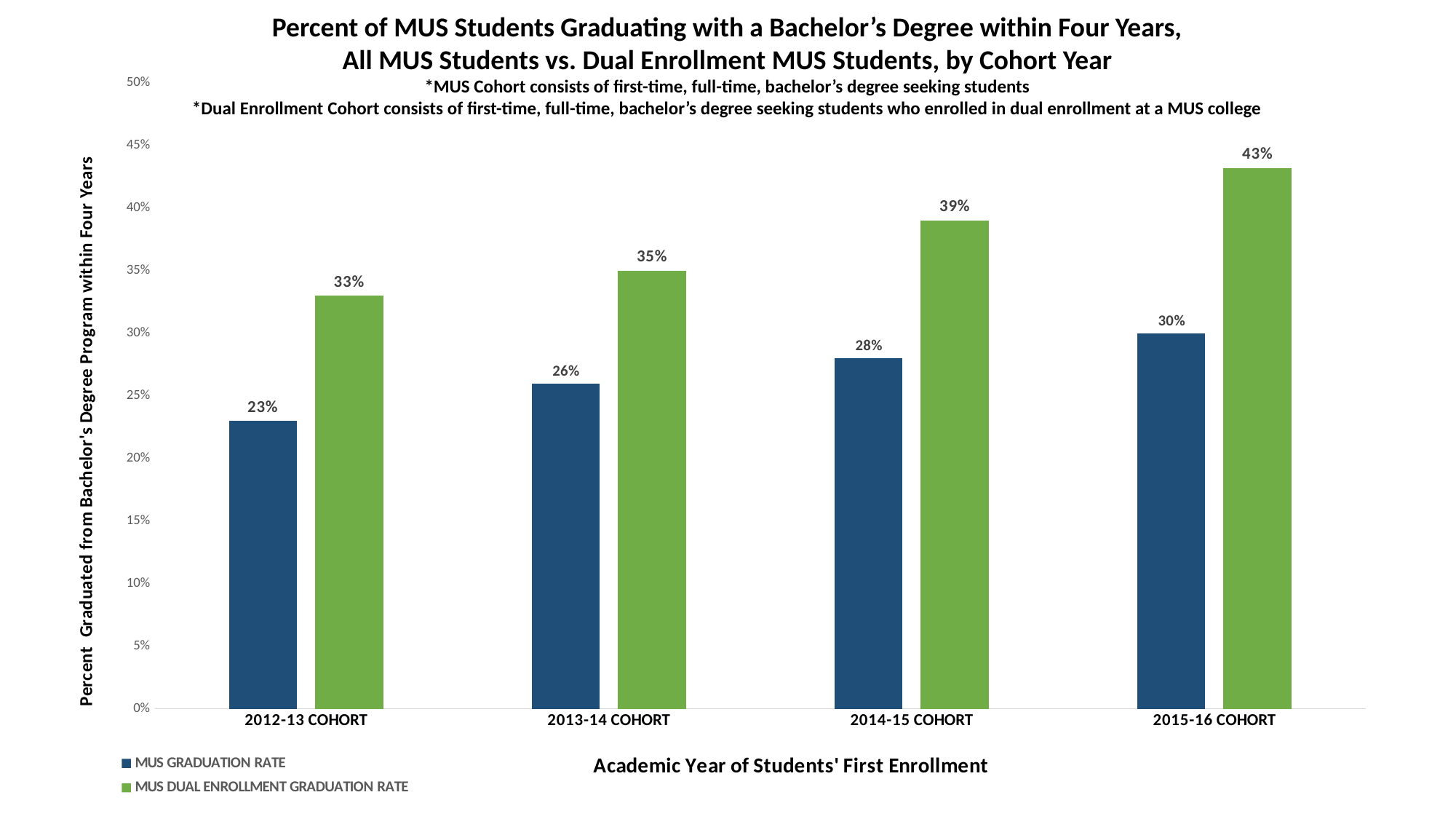
Is the MUS graduation rate for the 2015-16 cohort greater or less than 35%? less What is the difference between the MUS dual enrollment graduation rate and the MUS graduation rate for the 2014-15 cohort? 11% Do the MUS graduation rates rise or fall from the 2012-13 cohort to the 2015-16 cohort? rise What kind of chart is shown on the slide? bar chart Which cohort has the lowest MUS graduation rate? 2012-13 COHORT Which cohort has the highest MUS dual enrollment graduation rate? 2015-16 COHORT What is the MUS dual enrollment graduation rate for the 2015-16 cohort? 43% What is the MUS graduation rate for the 2012-13 cohort? 23% How many cohort years are shown on the x axis? 4 Which is larger for the 2013-14 cohort: the MUS graduation rate or the MUS dual enrollment graduation rate? MUS dual enrollment graduation rate What is the MUS dual enrollment graduation rate for the 2013-14 cohort? 35% How many series does the legend list? 2